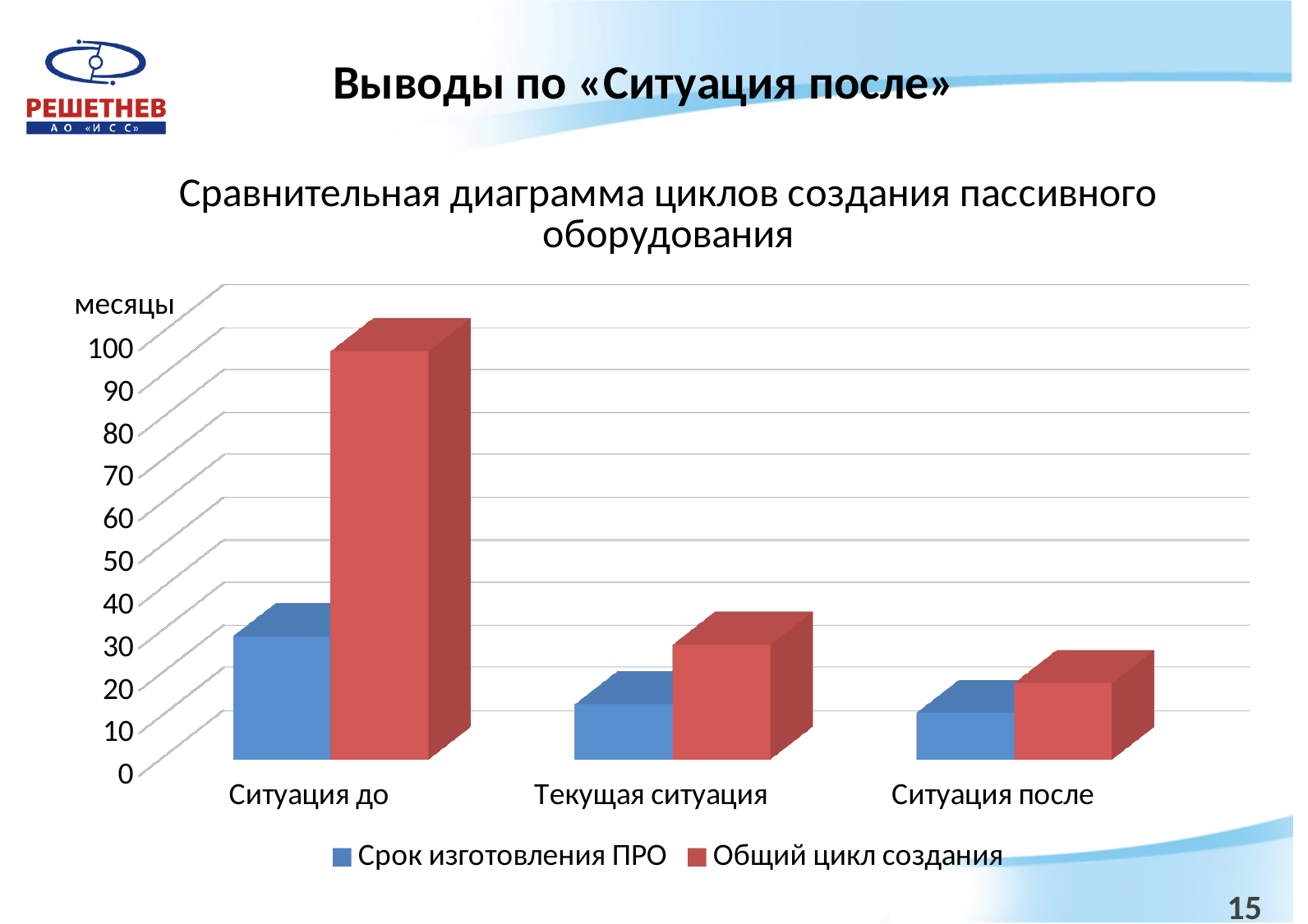
In the "Ситуация до" category, which is larger: "Срок изготовления ПРО" or "Общий цикл создания"? Общий цикл создания How many categories are shown on the x axis of the chart? 3 Which category has the highest value for "Общий цикл создания"? Ситуация до Which colour represents "Общий цикл создания" in the chart? Red How many series does the chart legend list? 2 What unit is shown on the vertical axis of the chart? месяцы Which category has the lowest value for "Общий цикл создания"? Ситуация после Is the value of "Общий цикл создания" for "Текущая ситуация" greater or less than 40? less Is the value of "Общий цикл создания" for "Ситуация до" greater or less than 80? greater Is the value of "Общий цикл создания" for "Ситуация после" greater or less than 30? less Do the values of "Общий цикл создания" rise or fall from "Ситуация до" to "Ситуация после"? fall What kind of chart is shown on the slide? Bar chart